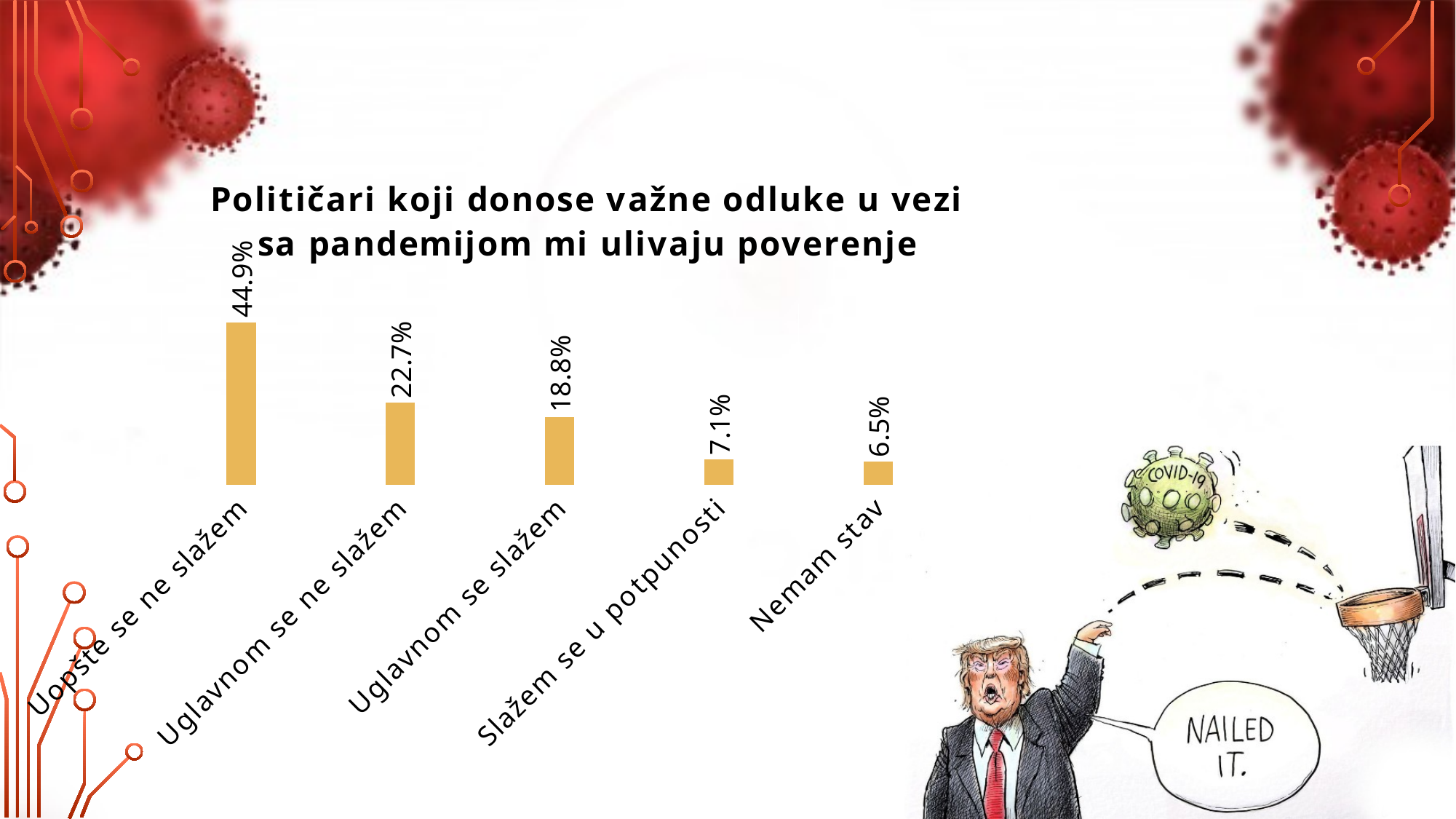
How many categories are shown in the chart? 5 What is the value for "Uopšte se ne slažem"? 44.9% Which category has the highest value? Uopšte se ne slažem What is the title of the chart? Političari koji donose važne odluke u vezi sa pandemijom mi ulivaju poverenje What is the difference between the values for "Uopšte se ne slažem" and "Uglavnom se ne slažem"? 22.2% What is the value for "Nemam stav"? 6.5% What is the value for "Uglavnom se slažem"? 18.8% Which category has the lowest value? Nemam stav What kind of chart is shown on the slide? Bar chart Which is larger, the value for "Uglavnom se slažem" or the value for "Slažem se u potpunosti"? Uglavnom se slažem What is the value for "Slažem se u potpunosti"? 7.1% What is the value for "Uglavnom se ne slažem"? 22.7%